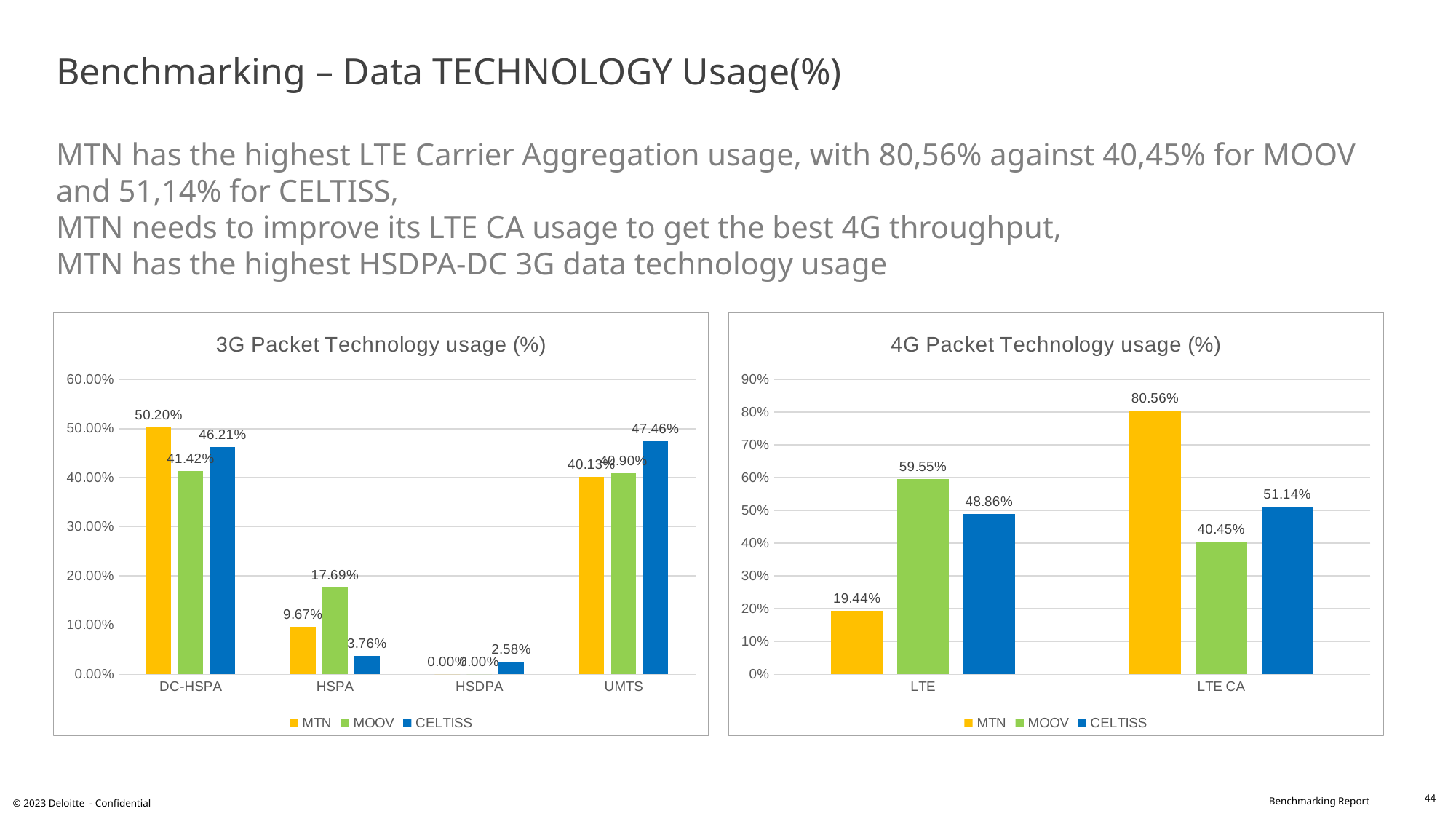
In the 4G Packet Technology usage (%) chart, is the value for CELTISS at LTE greater or less than 40%? greater In the 4G Packet Technology usage (%) chart, which operator has the highest value at LTE? MOOV In the 3G Packet Technology usage (%) chart, which operator has the lowest value at HSPA? CELTISS In the 3G Packet Technology usage (%) chart, which is larger at DC-HSPA: MTN or CELTISS? MTN In the 3G Packet Technology usage (%) chart, what is the value for CELTISS at UMTS? 47.46% How many categories are shown on the x axis of the 3G Packet Technology usage (%) chart? 4 In the 3G Packet Technology usage (%) chart, what is the value for MOOV at HSPA? 17.69% In the 4G Packet Technology usage (%) chart, what is the difference between MTN and MOOV at LTE CA? 40.11% What kind of chart is the 3G Packet Technology usage (%) chart? Bar chart In the 4G Packet Technology usage (%) chart, what is the value for MTN at LTE CA? 80.56% How many series does the legend of the 4G Packet Technology usage (%) chart list? 3 In the 3G Packet Technology usage (%) chart, what is the value for MTN at HSDPA? 0.00%